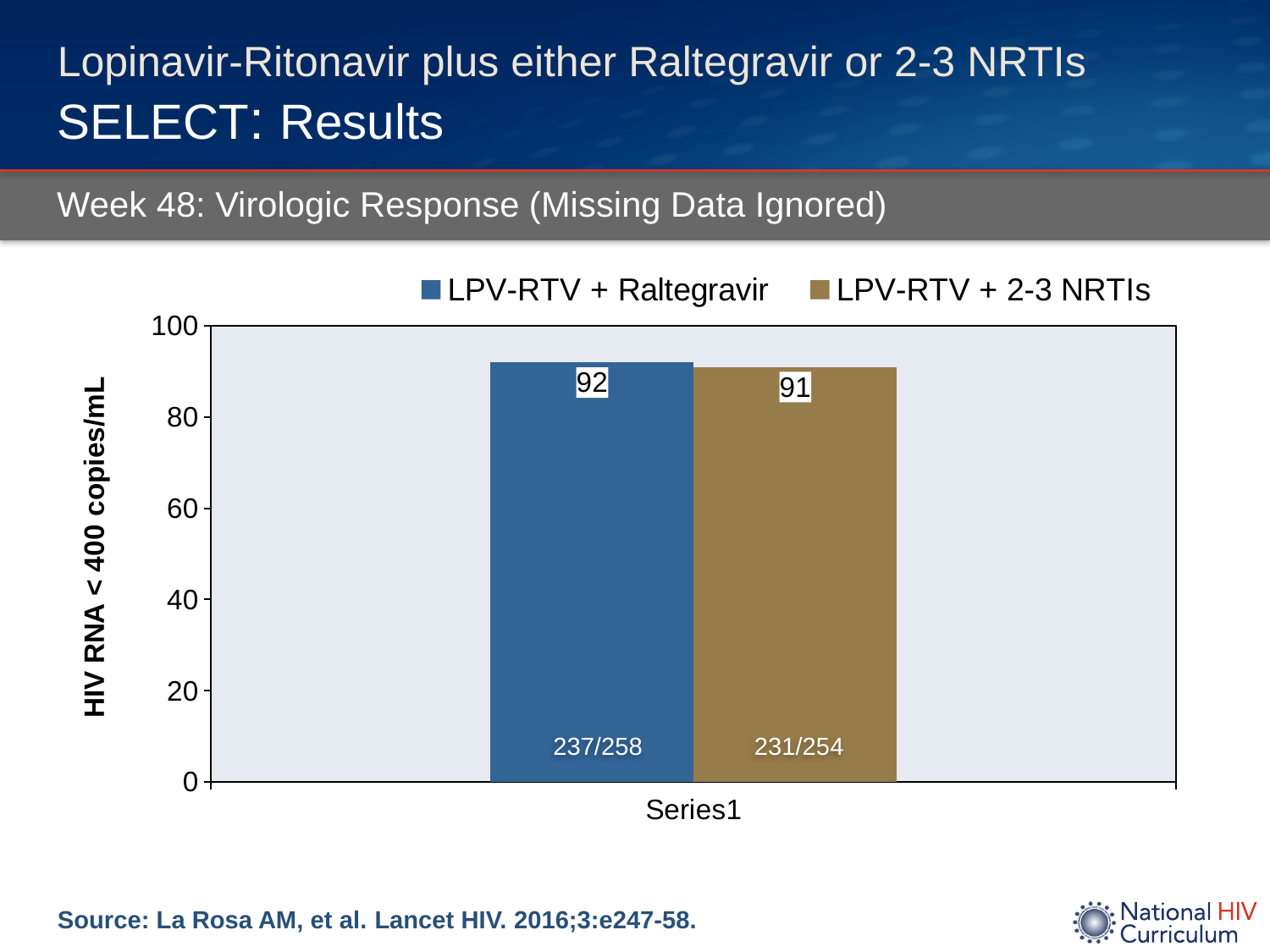
How many series does the legend list? 2 What is the maximum value shown on the y axis? 100 What is the difference between the values for LPV-RTV + Raltegravir and LPV-RTV + 2-3 NRTIs? 1 What fraction is printed inside the LPV-RTV + Raltegravir bar? 237/258 What value is shown for LPV-RTV + 2-3 NRTIs? 91 Which series has the higher value, LPV-RTV + Raltegravir or LPV-RTV + 2-3 NRTIs? LPV-RTV + Raltegravir What kind of chart is shown on the slide? Bar chart Which series has the lowest value in the chart? LPV-RTV + 2-3 NRTIs What value is shown for LPV-RTV + Raltegravir? 92 What fraction is printed inside the LPV-RTV + 2-3 NRTIs bar? 231/254 What is the label on the y axis of the chart? HIV RNA < 400 copies/mL Is the value for LPV-RTV + 2-3 NRTIs greater or less than 80? greater